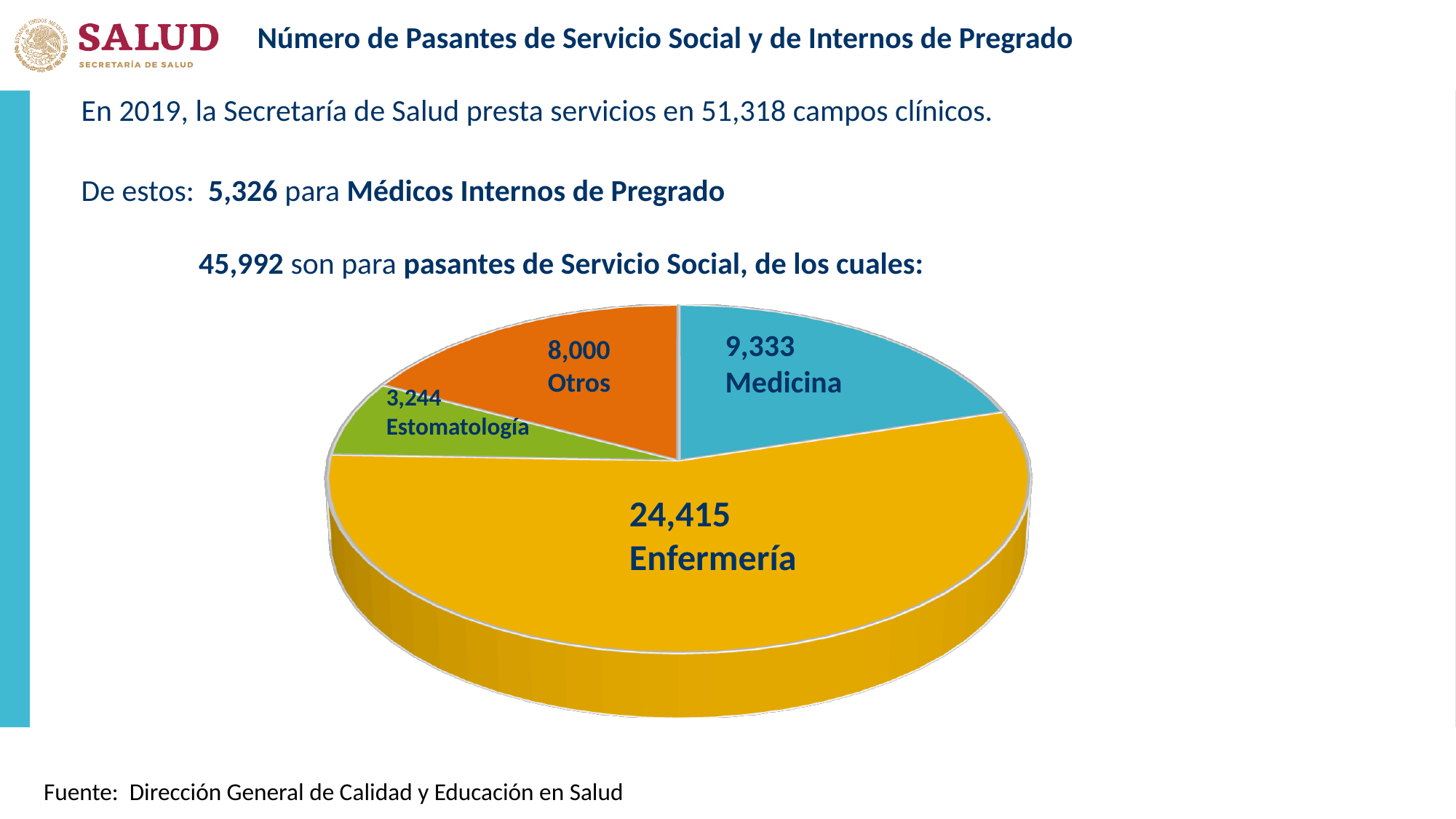
Which category has the smallest slice in the pie chart? Estomatología What is the value shown for Medicina in the pie chart? 9,333 Which is larger, the value for Medicina or the value for Otros? Medicina What is the difference between the values for Otros and Estomatología? 4,756 What is the difference between the values for Enfermería and Medicina? 15,082 What is the value shown for Enfermería in the pie chart? 24,415 What is the value shown for Estomatología in the pie chart? 3,244 How many slices does the pie chart have? 4 What colour is the Enfermería slice in the pie chart? Yellow Which category has the largest slice in the pie chart? Enfermería What kind of chart is shown on the slide? Pie chart What is the value shown for Otros in the pie chart? 8,000